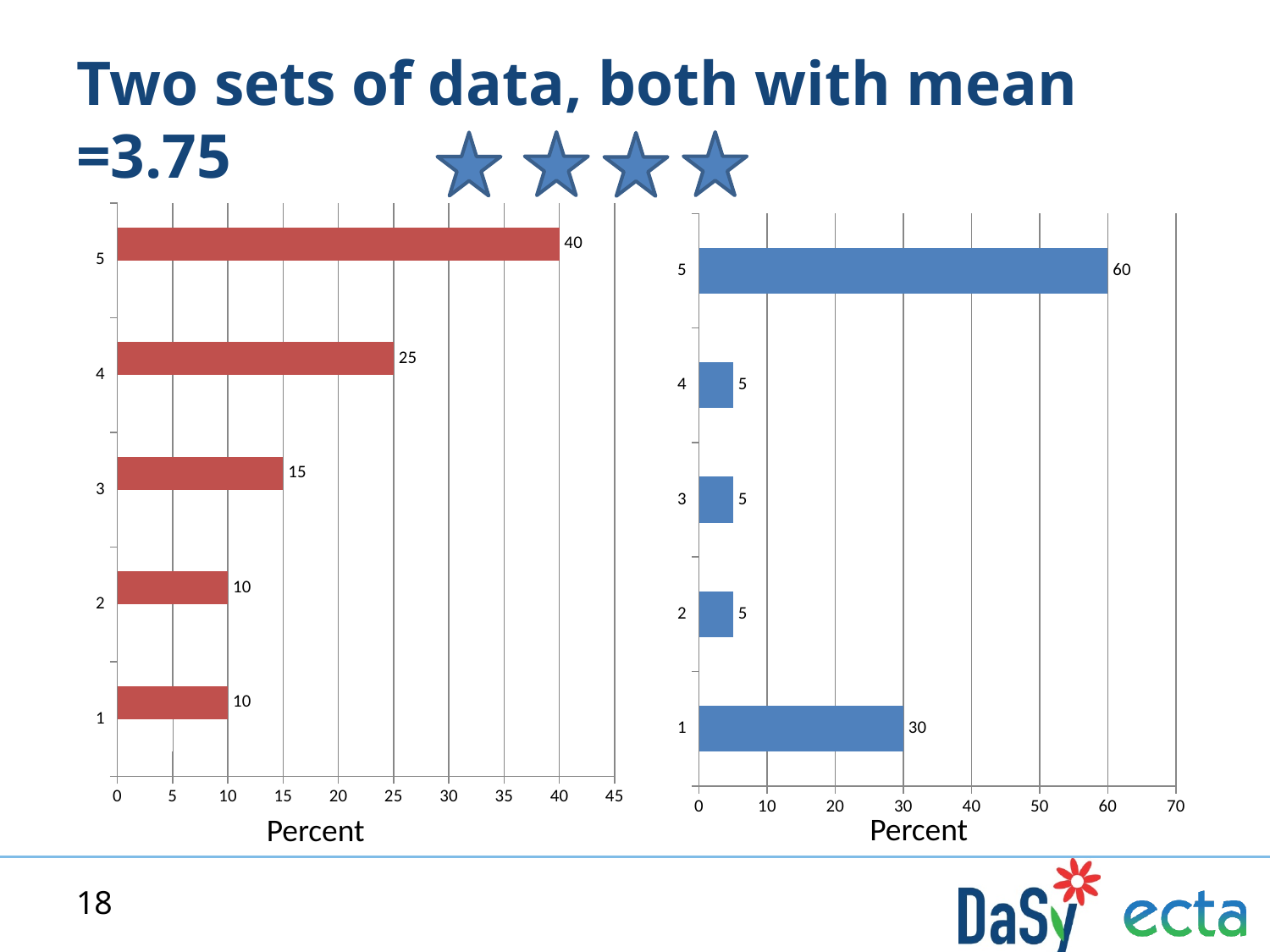
In the right chart, is the value for category 5 greater or less than 50? greater How many categories does the left chart show? 5 In the right chart, what is the difference between the values for category 5 and category 1? 30 What is the x-axis label of the left chart? Percent In the left chart, what is the difference between the values for category 5 and category 4? 15 What kind of chart is the right chart? bar chart In the left chart, what is the value for category 5? 40 In the left chart, which category has the highest value? 5 In the left chart, what is the value for category 3? 15 In the right chart, which category has the highest value? 5 In the right chart, what is the value for category 1? 30 In the left chart, which is larger, the value for category 4 or the value for category 3? category 4